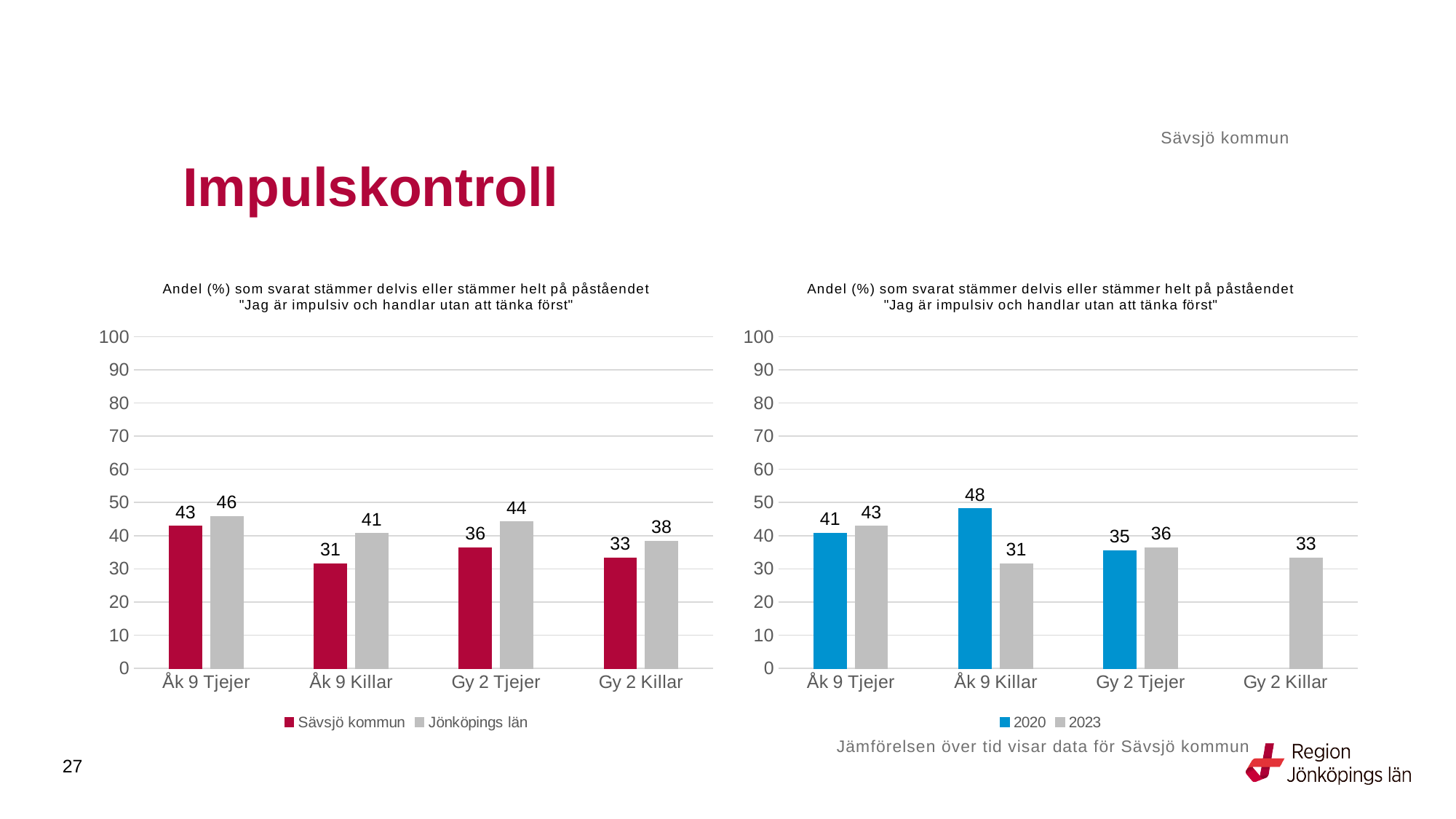
In the left chart, which category has the highest value for Jönköpings län? Åk 9 Tjejer In the right chart, what is the difference between 2020 and 2023 for Åk 9 Killar? 17 In the right chart, which is larger for Åk 9 Killar, 2020 or 2023? 2020 In the left chart, which category has the lowest value for Sävsjö kommun? Åk 9 Killar In the left chart, what is the value for Jönköpings län for Gy 2 Killar? 38 In the left chart, how many series does the legend list? 2 What kind of chart is the right chart? Bar chart In the left chart, what is the value for Sävsjö kommun for Åk 9 Tjejer? 43 In the right chart, how many categories are shown on the x axis? 4 In the right chart, what is the value for 2020 for Åk 9 Killar? 48 In the left chart, what is the difference between Jönköpings län and Sävsjö kommun for Åk 9 Killar? 10 In the right chart, what is the value for 2023 for Gy 2 Tjejer? 36